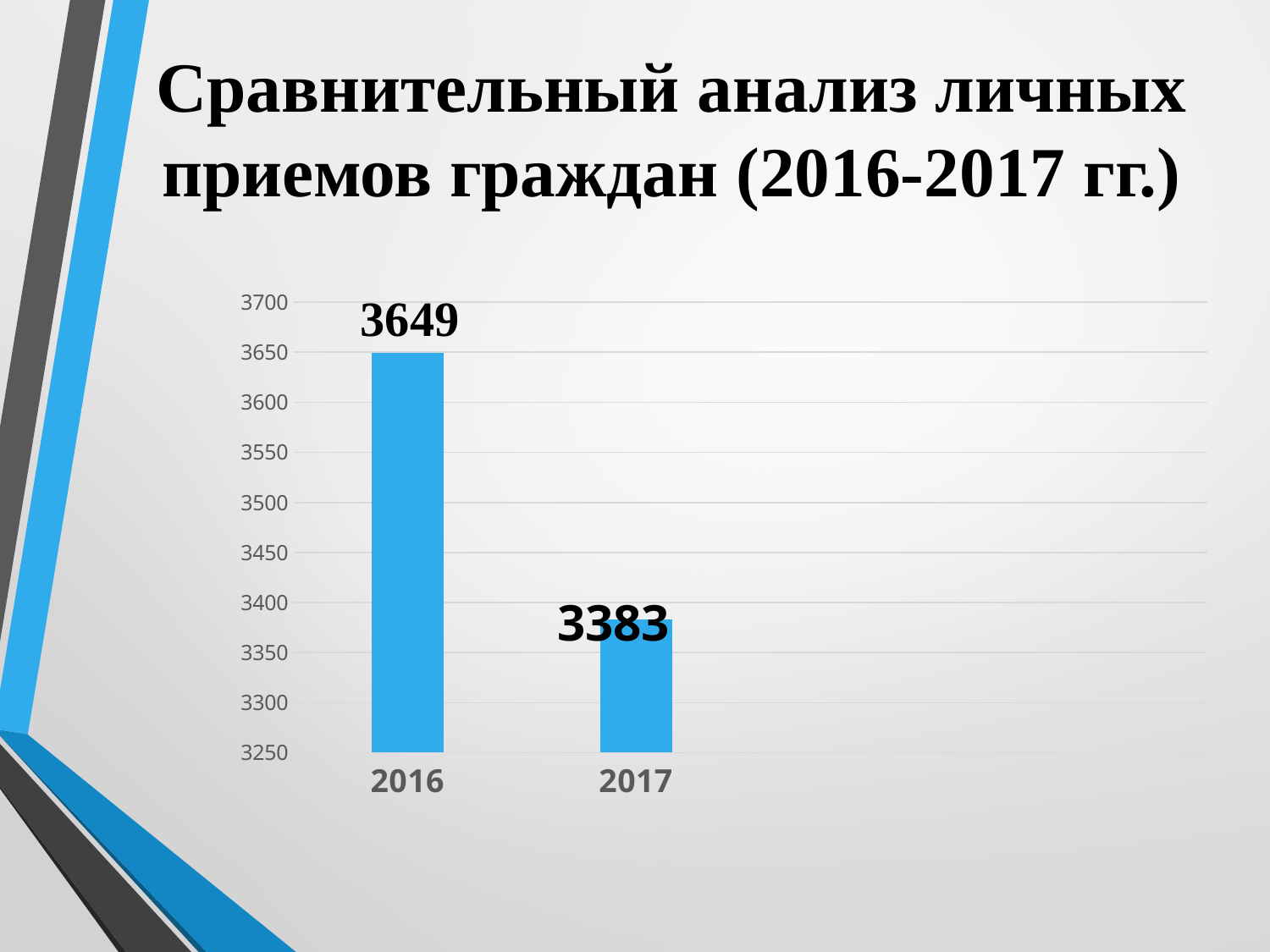
What is the title of the slide? Сравнительный анализ личных приемов граждан (2016-2017 гг.) Do the values rise or fall from 2016 to 2017? fall Is the value for 2017 greater or less than 3400? less Which year has the highest value? 2016 Which year has the lowest value? 2017 What is the value for 2016? 3649 How many bars are shown in the chart? 2 Is the value for 2016 greater or less than 3600? greater What is the difference between the values for 2016 and 2017? 266 Which is larger, the value for 2016 or the value for 2017? 2016 What is the value for 2017? 3383 What kind of chart is shown on the slide? bar chart